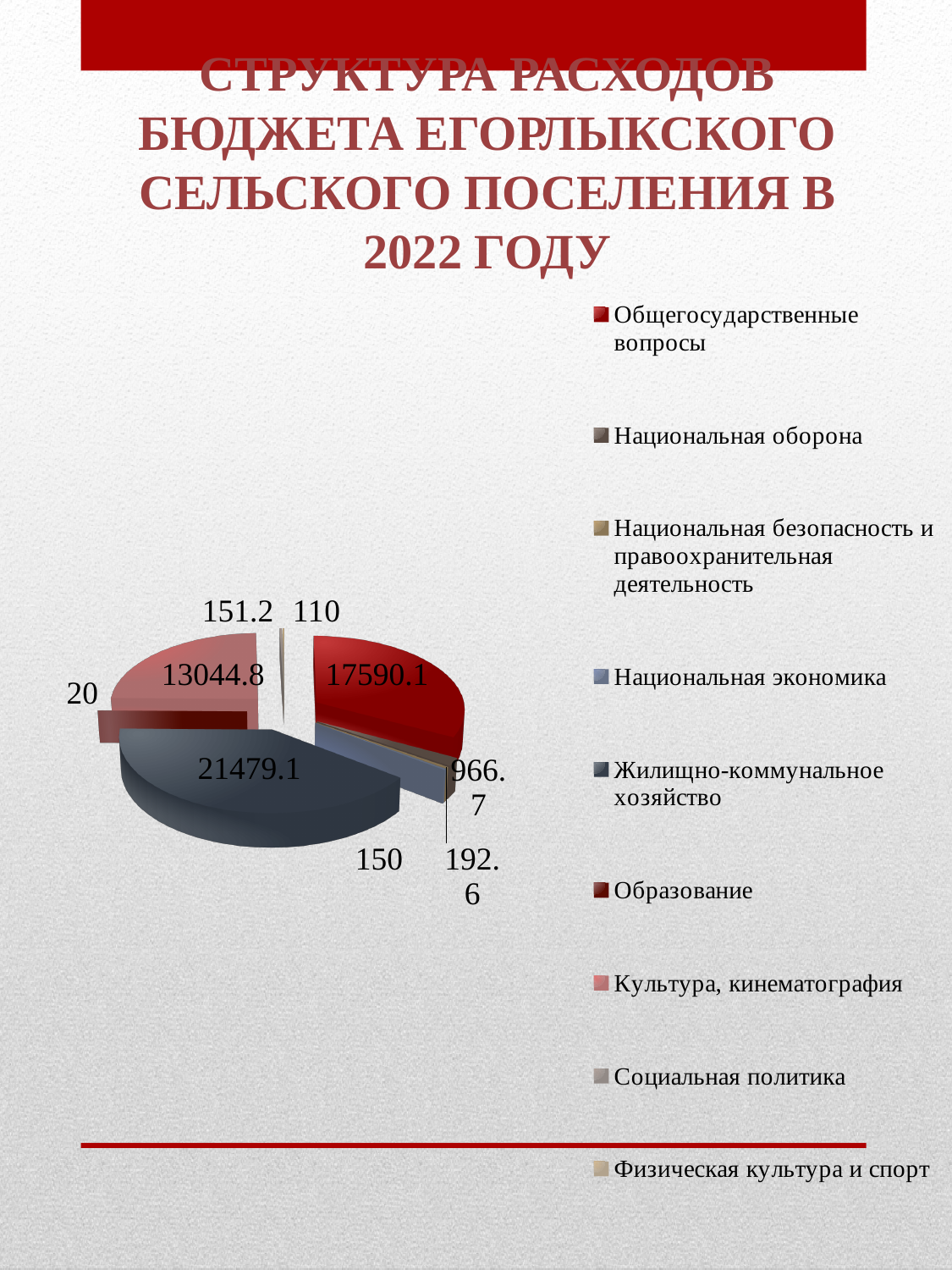
Which category has the largest slice of the pie? Жилищно-коммунальное хозяйство Which is larger: the value for Общегосударственные вопросы or the value for Культура, кинематография? Общегосударственные вопросы What kind of chart is shown on the slide? pie chart Which year does the chart title say the budget expenditure structure refers to? 2022 How many categories does the legend of the pie chart list? 9 What is the value shown for Образование? 20 What is the difference between the values for Жилищно-коммунальное хозяйство and Общегосударственные вопросы? 3889 What is the value shown for Физическая культура и спорт? 110 What is the value shown for Жилищно-коммунальное хозяйство? 21479.1 What is the value shown for Культура, кинематография? 13044.8 What is the value shown for Общегосударственные вопросы? 17590.1 Which category has the smallest value in the pie chart? Образование